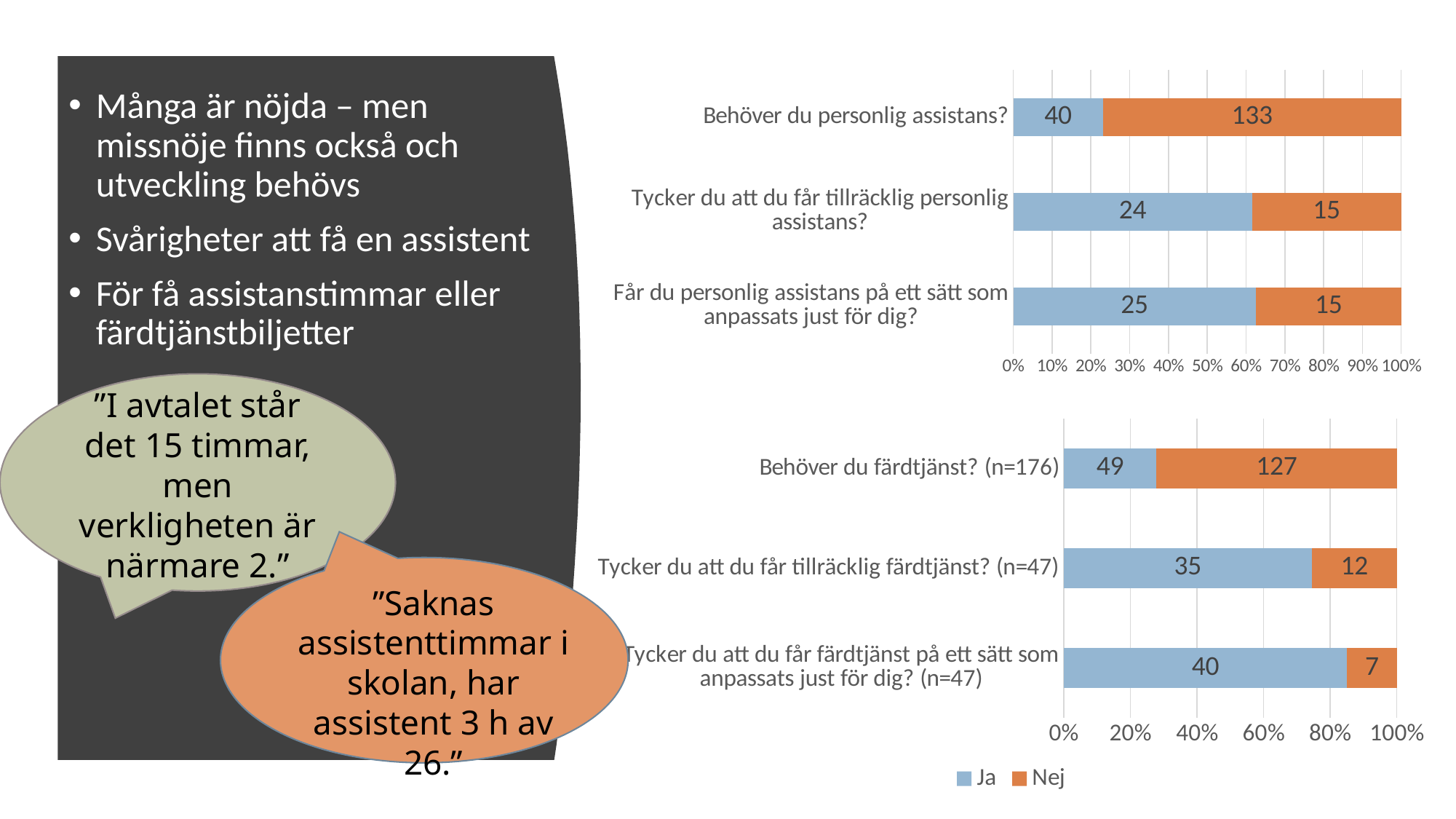
In the top chart, what is the total number of respondents for 'Behöver du personlig assistans?' 173 What type of chart is the top chart? Stacked bar chart In the top chart, how many respondents answered 'Nej' to 'Behöver du personlig assistans?' 133 In the bottom chart, what is the difference between the 'Ja' and 'Nej' counts for 'Tycker du att du får tillräcklig färdtjänst? (n=47)' 23 How many series does the legend under the bottom chart list? 2 In the bottom chart, how many respondents answered 'Nej' to 'Tycker du att du får färdtjänst på ett sätt som anpassats just för dig? (n=47)' 7 In the bottom chart, is the 'Ja' count for 'Behöver du färdtjänst? (n=176)' larger or smaller than the 'Nej' count? smaller In the bottom chart, which question has the smallest 'Nej' count? Tycker du att du får färdtjänst på ett sätt som anpassats just för dig? (n=47) In the top chart, how many respondents answered 'Ja' to 'Tycker du att du får tillräcklig personlig assistans?' 24 In the top chart, which question has the largest 'Nej' count? Behöver du personlig assistans? How many questions (categories) are shown in the bottom chart? 3 In the bottom chart, how many respondents answered 'Ja' to 'Behöver du färdtjänst? (n=176)' 49